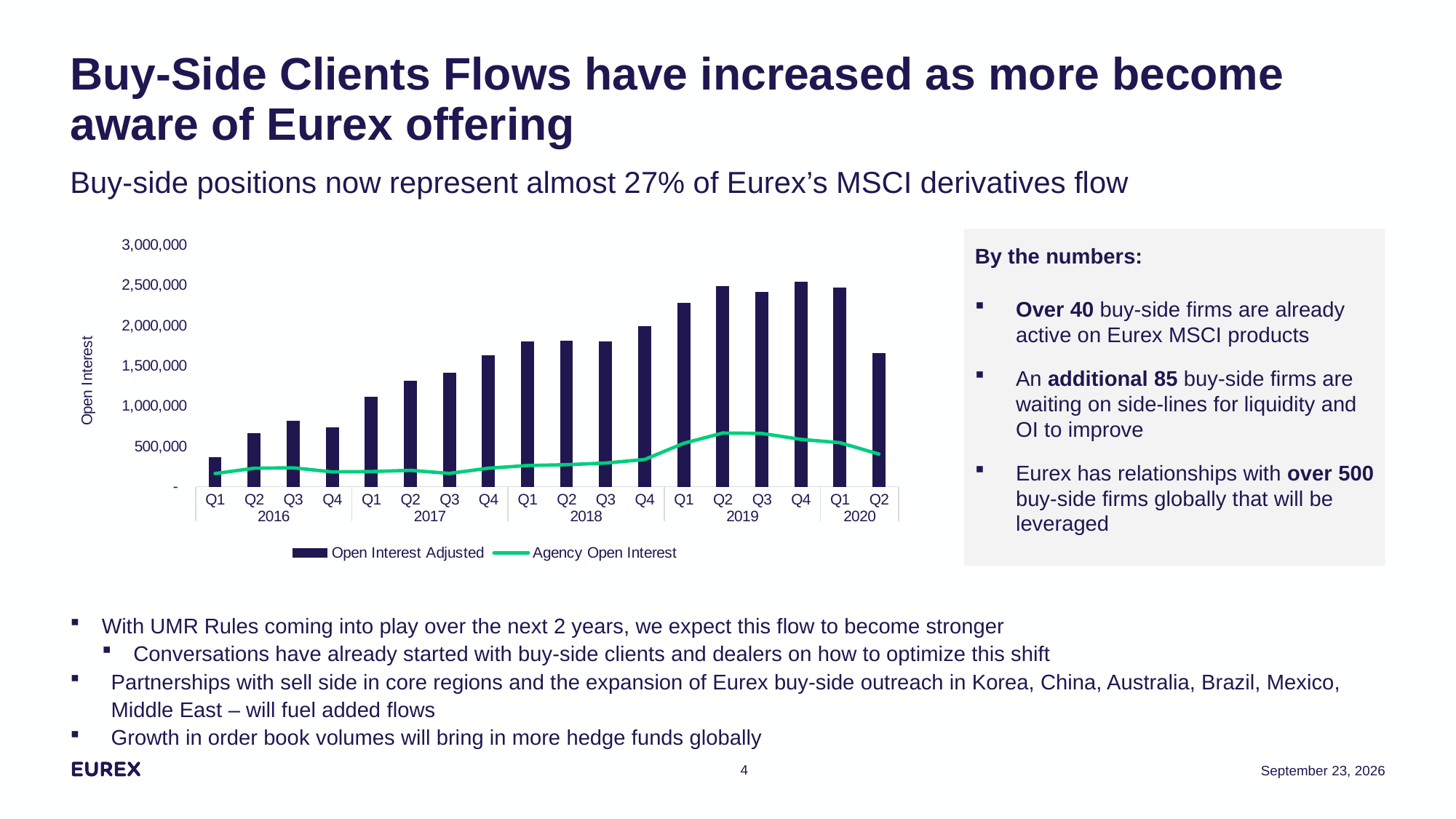
Is the Open Interest Adjusted value for Q1 2016 greater or less than 500,000? less Is the Open Interest Adjusted value for Q3 2017 greater or less than 1,500,000? less Is the Open Interest Adjusted value for Q1 2019 greater or less than 2,000,000? greater Do the Open Interest Adjusted bars generally rise or fall from Q1 2016 to Q4 2019? rise Which quarter has the highest Open Interest Adjusted bar? Q4 2019 How many quarterly bars are plotted in the chart? 18 How many series does the chart legend list? 2 Which has the larger Open Interest Adjusted value, Q1 2020 or Q2 2020? Q1 2020 What kind of chart is shown on the slide? A bar chart with a line series What are the two series named in the chart legend? Open Interest Adjusted and Agency Open Interest Which quarter has the lowest Open Interest Adjusted bar? Q1 2016